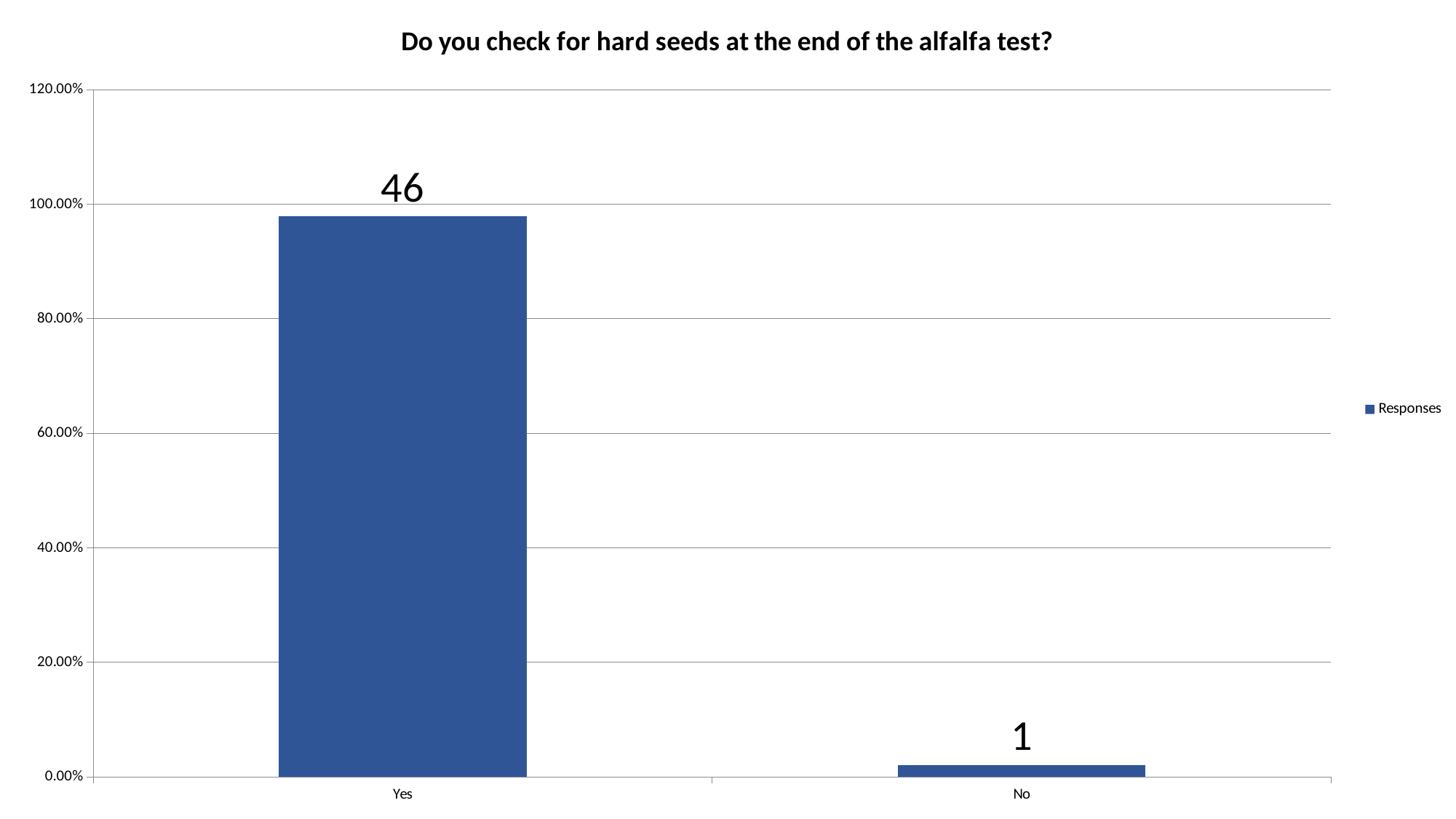
Which category has the lowest bar? No Which category has the highest bar? Yes What kind of chart is shown on the slide? bar chart What is the difference between the data labels for 'Yes' and 'No'? 45 What is the data label shown above the 'No' bar? 1 How many series does the legend list? 1 What is the data label shown above the 'Yes' bar? 46 What is the title of the chart? Do you check for hard seeds at the end of the alfalfa test? Is the bar for 'Yes' greater or less than 80.00% on the axis? greater Is the bar for 'No' greater or less than 20.00% on the axis? less How many categories are shown on the x axis? 2 Which is larger, the value for 'Yes' or the value for 'No'? Yes